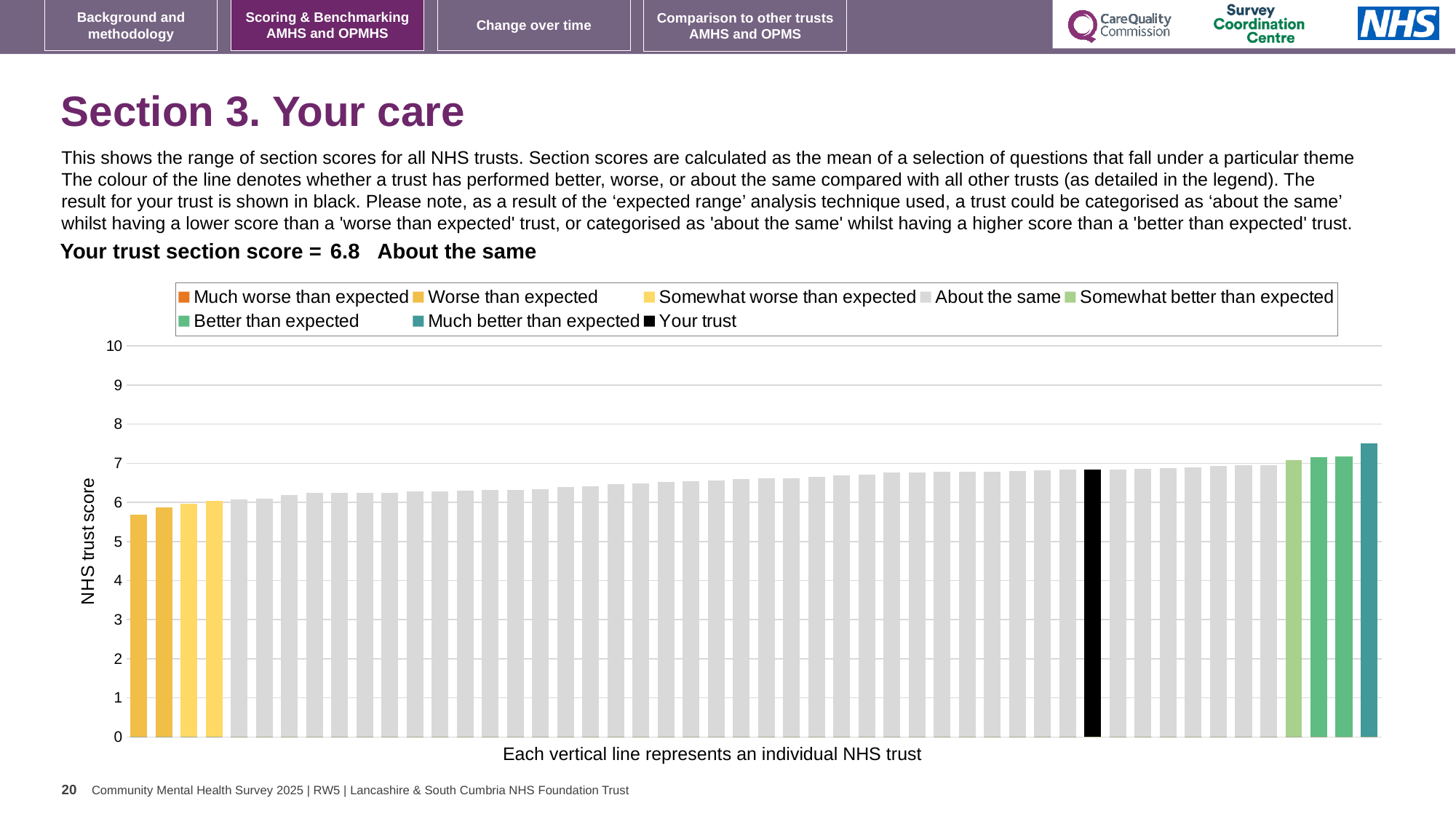
What kind of chart is shown on the slide? bar chart Which legend category does the tallest bar belong to? Much better than expected Which legend category is your trust's section score placed in? About the same Is the value of the black 'Your trust' bar greater or less than 6? greater Is the value of the rightmost (highest) bar greater or less than 7? greater What is the label on the vertical axis of the chart? NHS trust score Is the value of the leftmost (lowest) bar greater or less than 6? less What is the section score for your trust shown on the slide? 6.8 Do the bar values rise or fall moving from left to right along the x axis? rise How many bars are coloured as 'Better than expected'? 2 Which legend category does the shortest bar belong to? Worse than expected How many entries does the chart legend list? 8